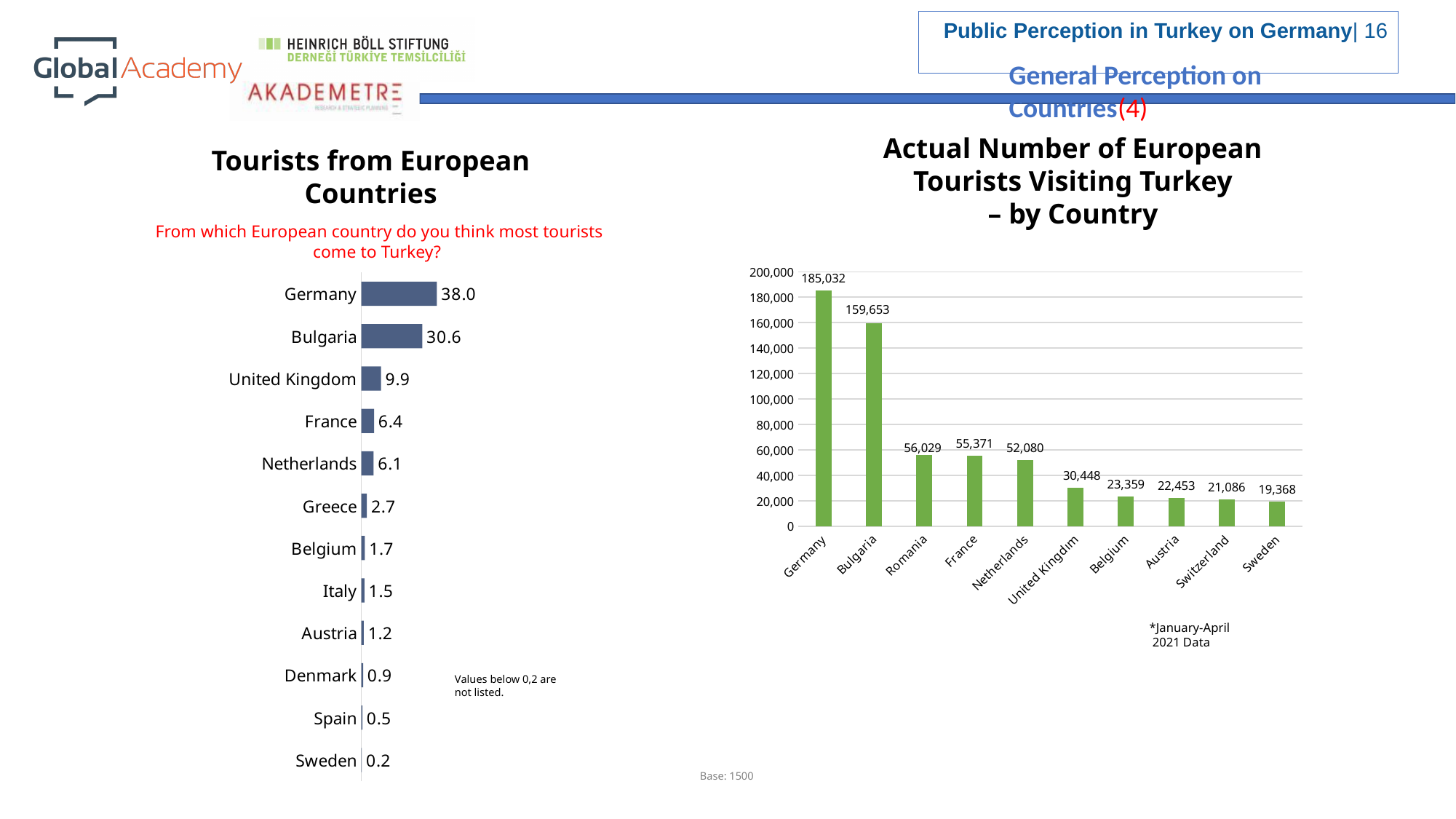
In the 'Tourists from European Countries' chart, what is the difference between the values for Germany and Bulgaria? 7.4 In the 'Actual Number of European Tourists Visiting Turkey – by Country' chart, how many countries are shown? 10 In the 'Tourists from European Countries' chart, what is the value for United Kingdom? 9.9 In the 'Actual Number of European Tourists Visiting Turkey – by Country' chart, what is the difference between the values for Germany and Bulgaria? 25,379 What kind of chart is the 'Actual Number of European Tourists Visiting Turkey – by Country' chart? Bar chart In the 'Tourists from European Countries' chart, how many countries are listed? 12 In the 'Actual Number of European Tourists Visiting Turkey – by Country' chart, which country has the highest value? Germany In the 'Tourists from European Countries' chart, which country has the lowest value? Sweden In the 'Tourists from European Countries' chart, what is the value for Germany? 38.0 In the 'Tourists from European Countries' chart, which is larger, the value for France or the value for Netherlands? France In the 'Actual Number of European Tourists Visiting Turkey – by Country' chart, what is the value for Romania? 56,029 In the 'Actual Number of European Tourists Visiting Turkey – by Country' chart, do the values rise or fall from left to right along the x axis? Fall